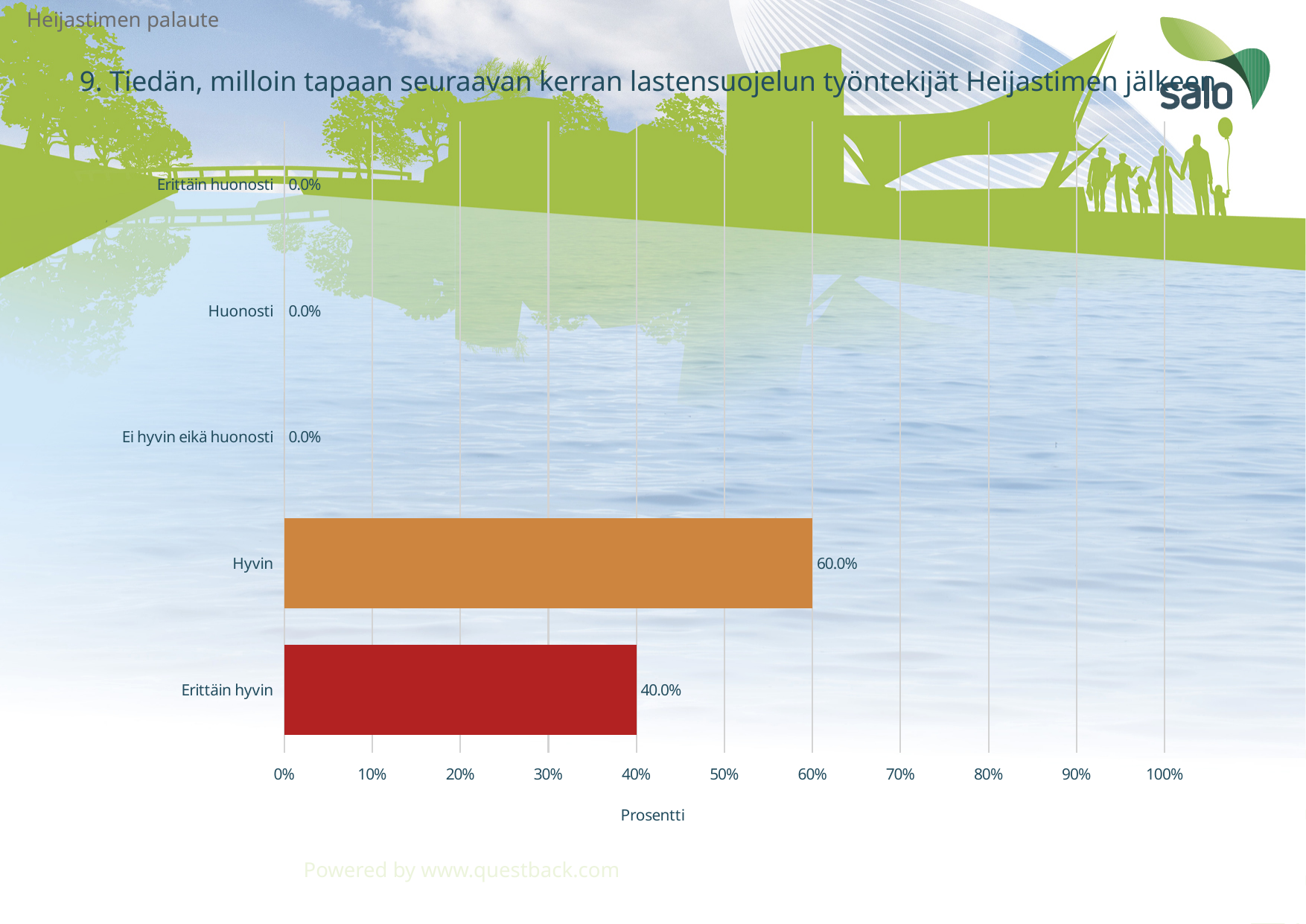
What is the value for Ei hyvin eikä huonosti? 0.0% What is the value for Hyvin? 60.0% What is the label of the horizontal axis? Prosentti What is the difference between the values for Hyvin and Erittäin hyvin? 20.0% Which is larger, the value for Hyvin or the value for Erittäin hyvin? Hyvin What kind of chart is shown on the slide? bar chart What is the value for Huonosti? 0.0% Is the value for Hyvin greater or less than 50%? greater What colour is the bar for Erittäin hyvin? red What is the value for Erittäin hyvin? 40.0% Which category has the highest value? Hyvin How many categories are shown on the chart? 5